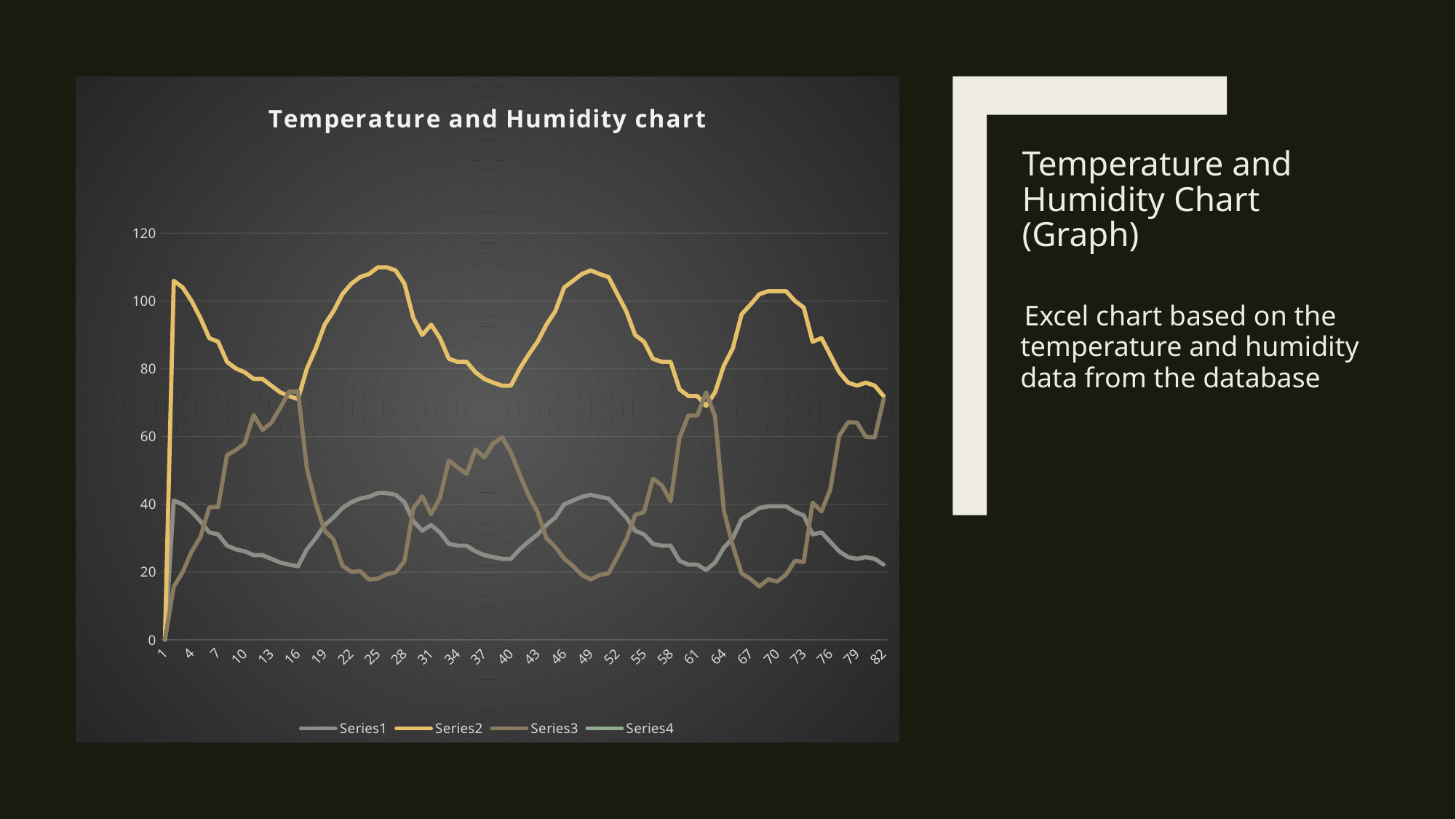
What is the title of the chart? Temperature and Humidity chart How many series does the legend list? 4 Which series reaches the highest value anywhere on the chart? Series2 What kind of chart is shown on the slide? line chart What is the highest value shown on the vertical axis? 120 Is the value of Series3 at x = 25 greater or less than 40? less Is the value of Series1 at x = 40 greater or less than 40? less Is the value of Series2 at x = 40 greater or less than 60? greater At x = 40, which is larger: Series1 or Series3? Series3 At x = 25, which is larger: Series1 or Series2? Series2